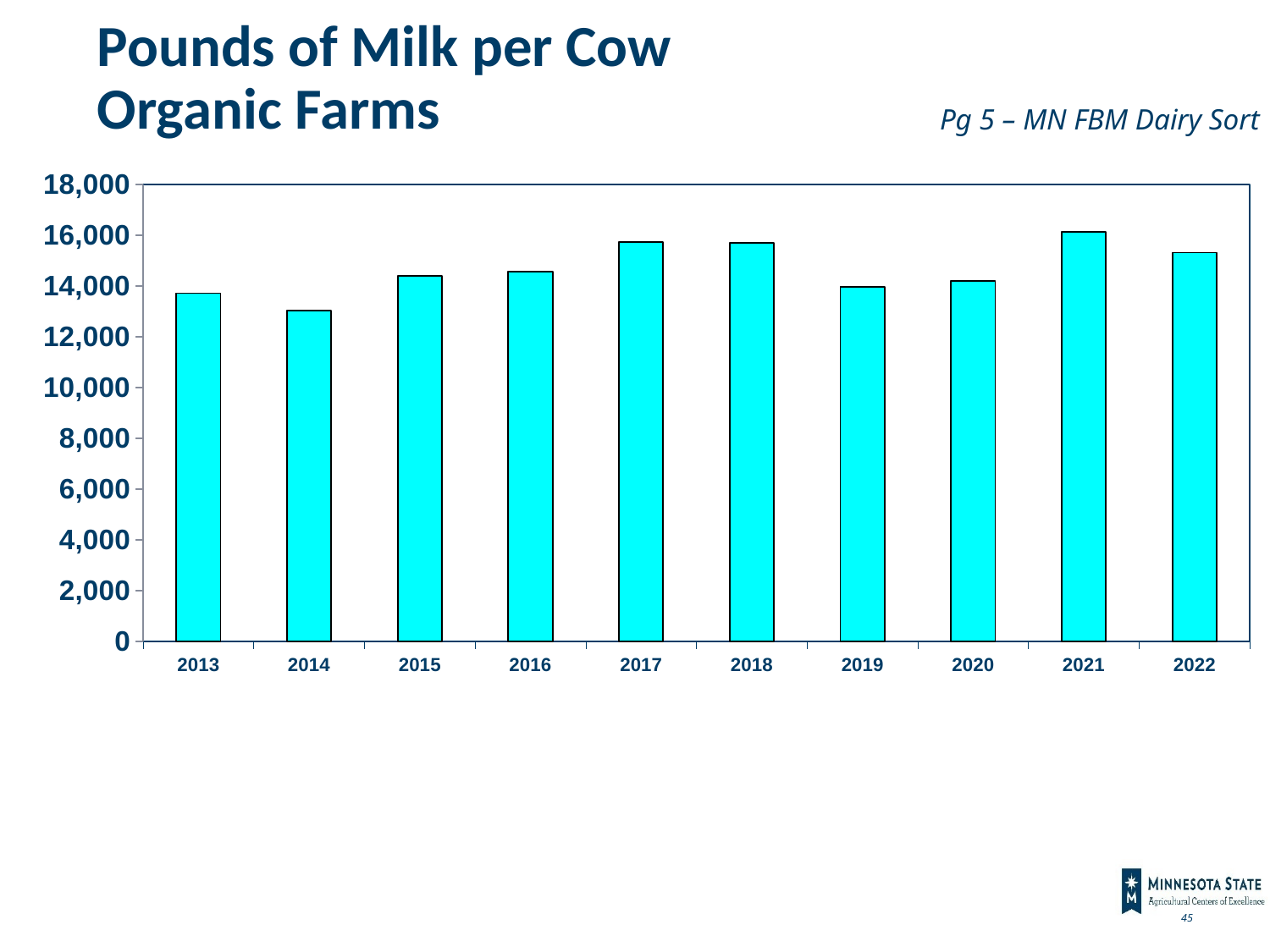
Is the value for 2021 greater or less than 16,000? greater Which year has the larger value, 2021 or 2022? 2021 Which year has the highest pounds of milk per cow? 2021 Which year has the larger value, 2014 or 2015? 2015 Is the value for 2014 greater or less than 14,000? less Which year has the lowest pounds of milk per cow? 2014 Is the value for 2017 greater or less than 14,000? greater Do the values rise or fall from 2019 to 2021? rise What is the title of the chart on the slide? Pounds of Milk per Cow Organic Farms How many years are shown on the x axis of the chart? 10 What kind of chart is shown on the slide? bar chart